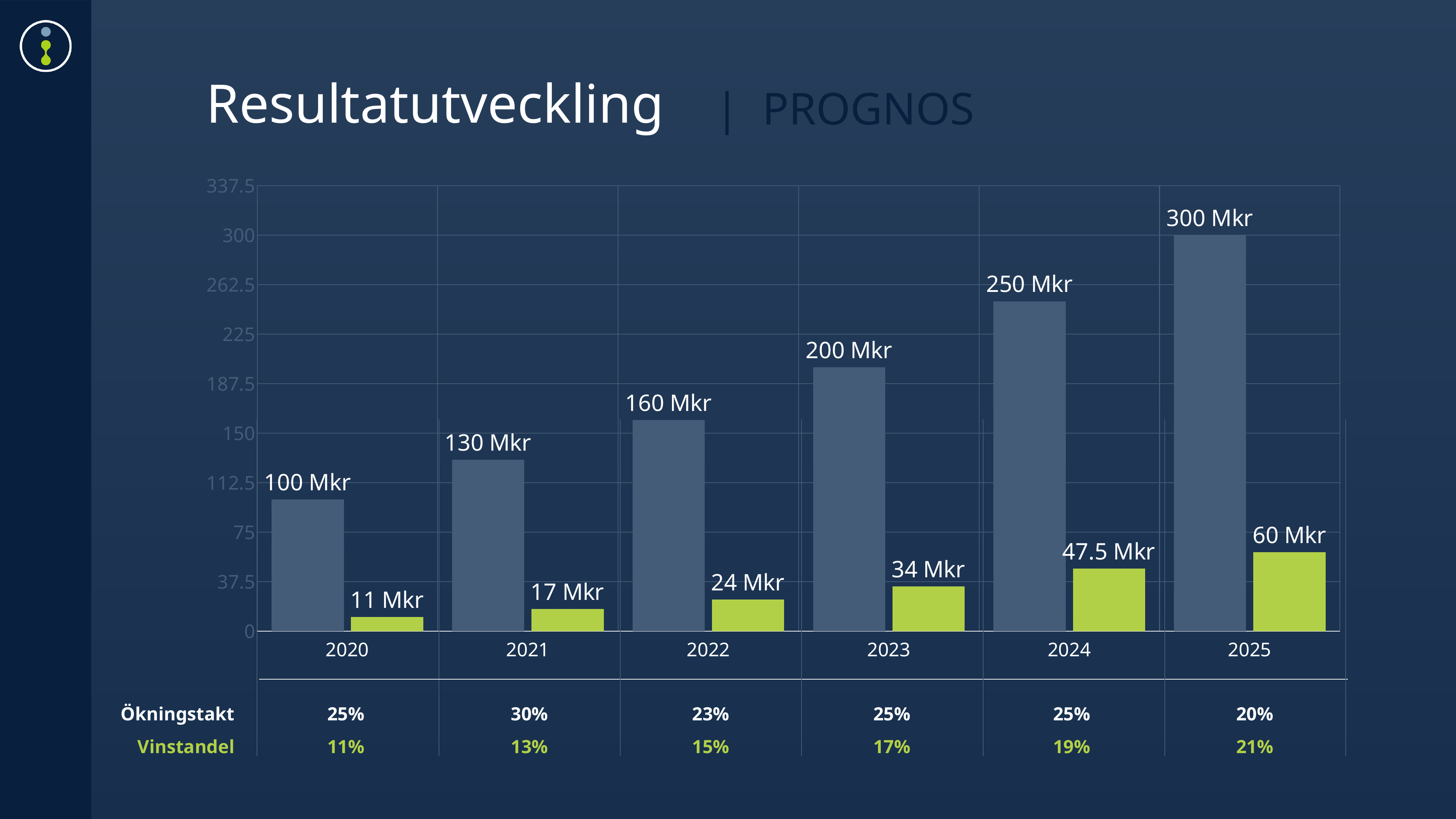
Which year has the lowest green bar? 2020 What kind of chart is shown on the slide? Bar chart How many years are shown on the x axis? 6 What is the value of the blue-grey bar for 2022? 160 Mkr Do the blue-grey bar values rise or fall from 2020 to 2025? Rise What is the difference between the green bar values for 2023 and 2022? 10 Mkr What is the title of the slide containing the chart? Resultatutveckling What is the value of the green bar for 2024? 47.5 Mkr What is the Ökningstakt value shown for 2021 below the chart? 30% What is the difference between the blue-grey bar values for 2025 and 2024? 50 Mkr Which is larger: the green bar for 2025 or the blue-grey bar for 2020? The blue-grey bar for 2020 Which year has the highest blue-grey bar? 2025